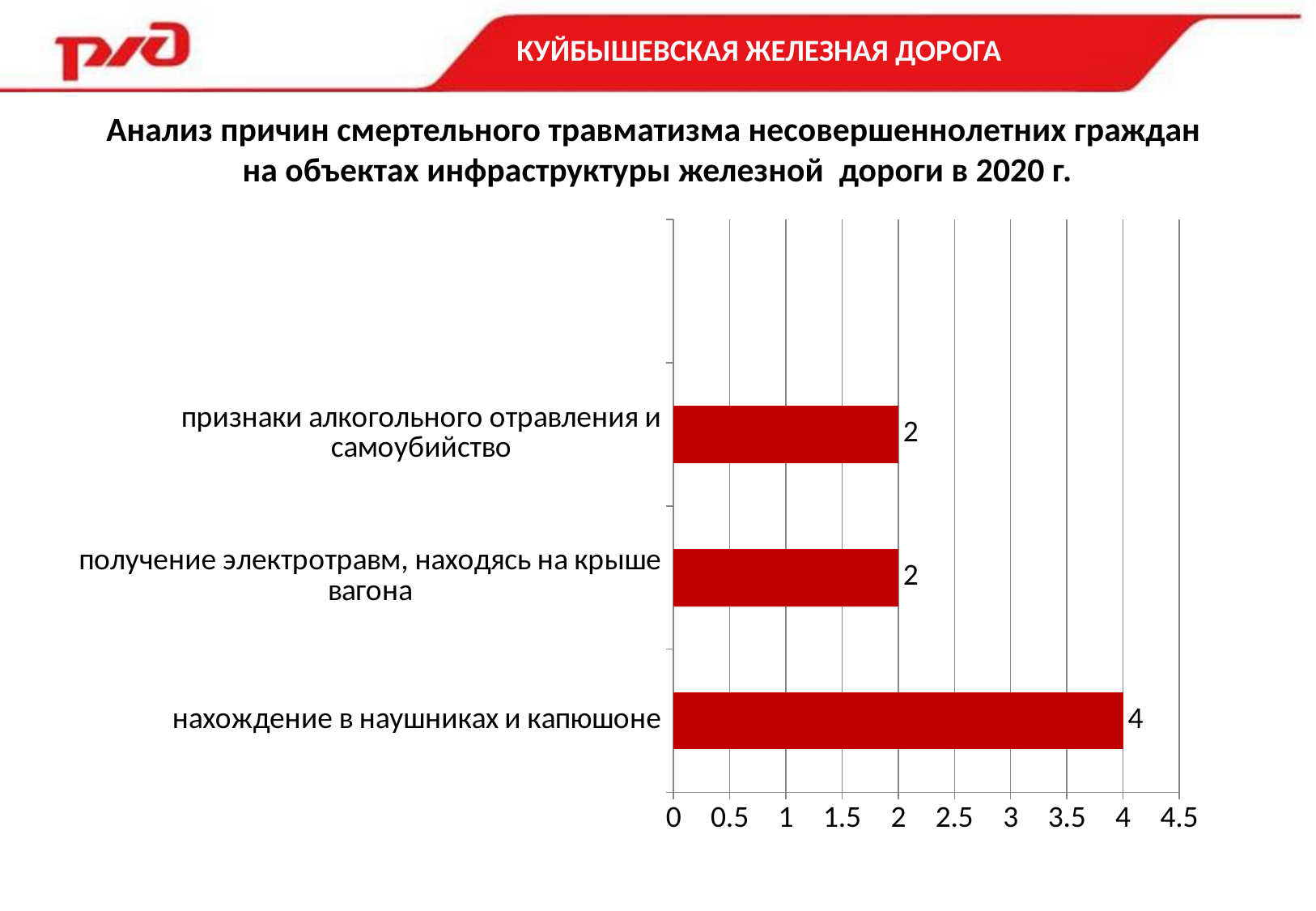
What kind of chart is shown on the slide? bar chart What is the difference between the value for "нахождение в наушниках и капюшоне" and the value for "получение электротравм, находясь на крыше вагона"? 2 Is the value for "признаки алкогольного отравления и самоубийство" greater or less than 3? less What is the total of all three values shown in the chart? 8 What colour are the bars in the chart? red What is the value for "признаки алкогольного отравления и самоубийство"? 2 What is the value for "нахождение в наушниках и капюшоне"? 4 Which is larger: the value for "нахождение в наушниках и капюшоне" or the value for "признаки алкогольного отравления и самоубийство"? нахождение в наушниках и капюшоне What is the value for "получение электротравм, находясь на крыше вагона"? 2 Is the value for "нахождение в наушниках и капюшоне" greater or less than 3? greater Which category has the highest value? нахождение в наушниках и капюшоне How many categories are shown in the chart? 3